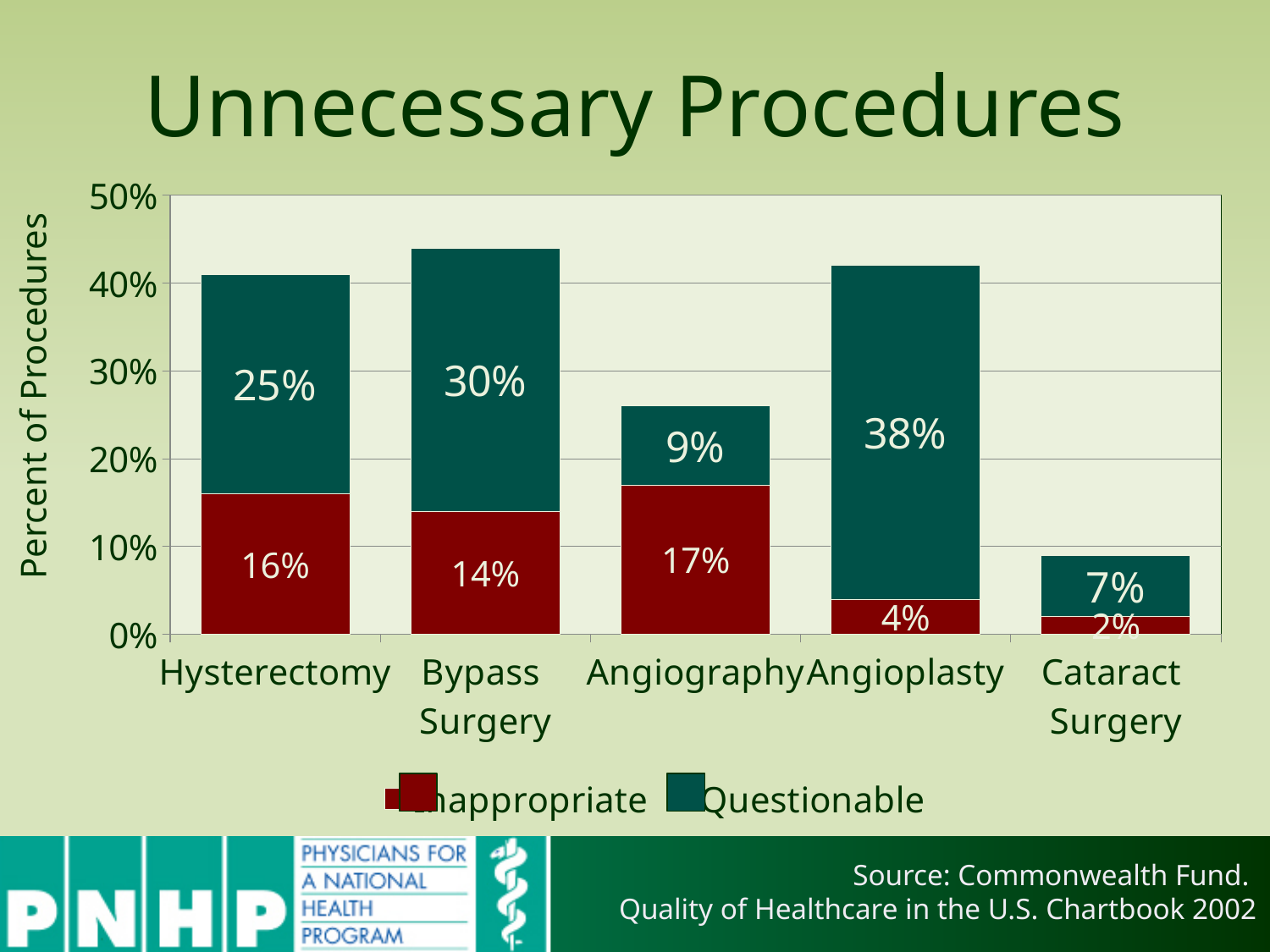
Which procedure has the highest Questionable percentage? Angioplasty Is the Inappropriate percentage higher for Hysterectomy or for Angioplasty? Hysterectomy Which procedure has the highest Inappropriate percentage? Angiography What is the difference between the Questionable percentages for Bypass Surgery and Hysterectomy? 5% What is the Inappropriate percentage for Bypass Surgery? 14% How many series does the legend list? 2 What type of chart is shown on the slide? Stacked bar chart What is the Questionable percentage for Angiography? 9% Which procedure has the lowest Questionable percentage? Cataract Surgery How many procedures are shown on the x axis? 5 What is the total percentage of unnecessary procedures for Bypass Surgery (Inappropriate plus Questionable)? 44% What is the Questionable percentage for Angioplasty? 38%